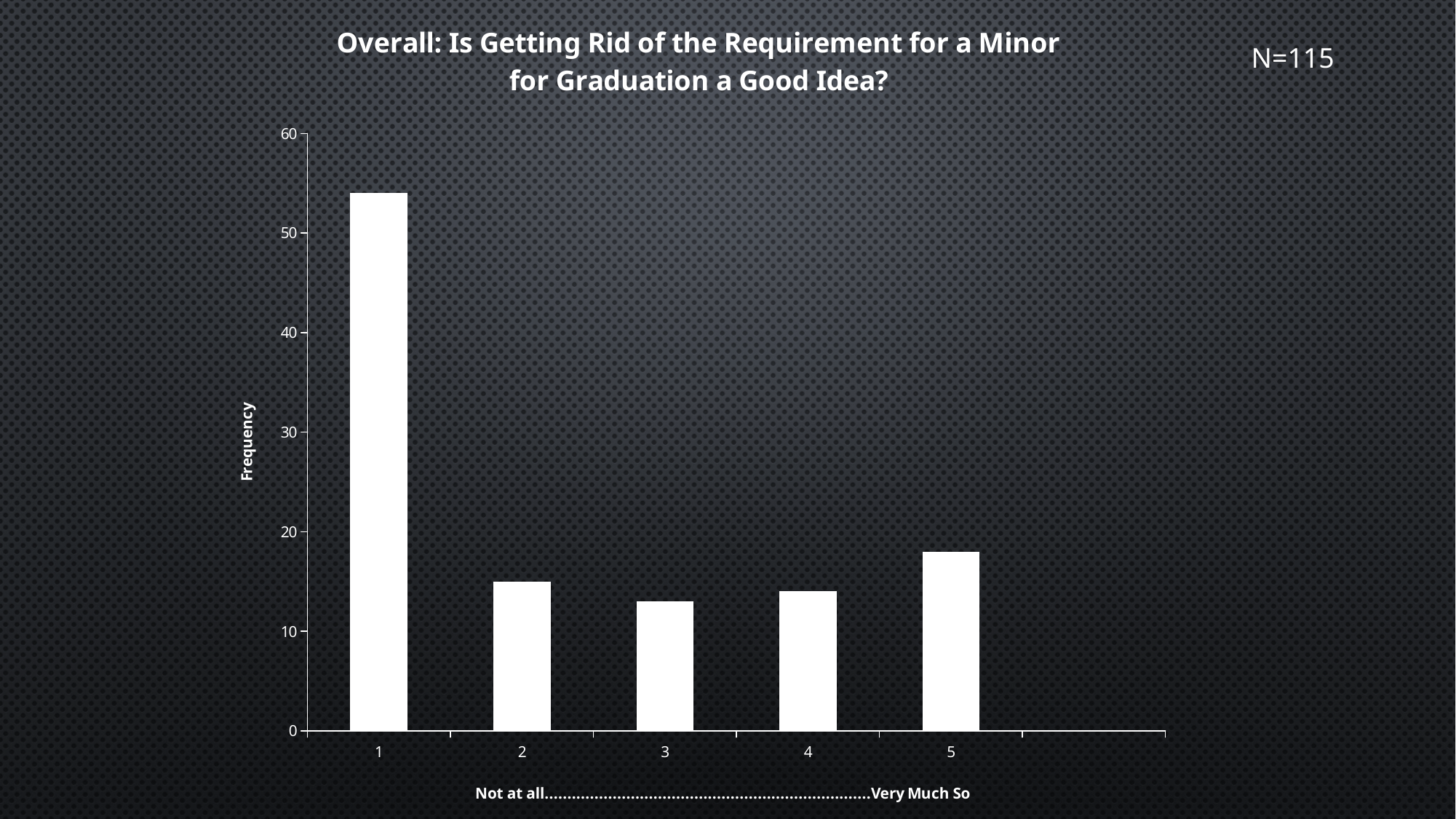
Is the frequency for category 4 greater or less than 20? less Which category has the highest frequency? 1 Which has a higher frequency, category 1 or category 5? 1 Is the frequency for category 3 greater or less than 10? greater What kind of chart is shown on the slide? bar chart What is the label on the y axis of the chart? Frequency Is the frequency for category 2 greater or less than 20? less Which has a higher frequency, category 2 or category 5? 5 What sample size (N) is shown on the slide? N=115 How many categories are plotted on the x axis? 5